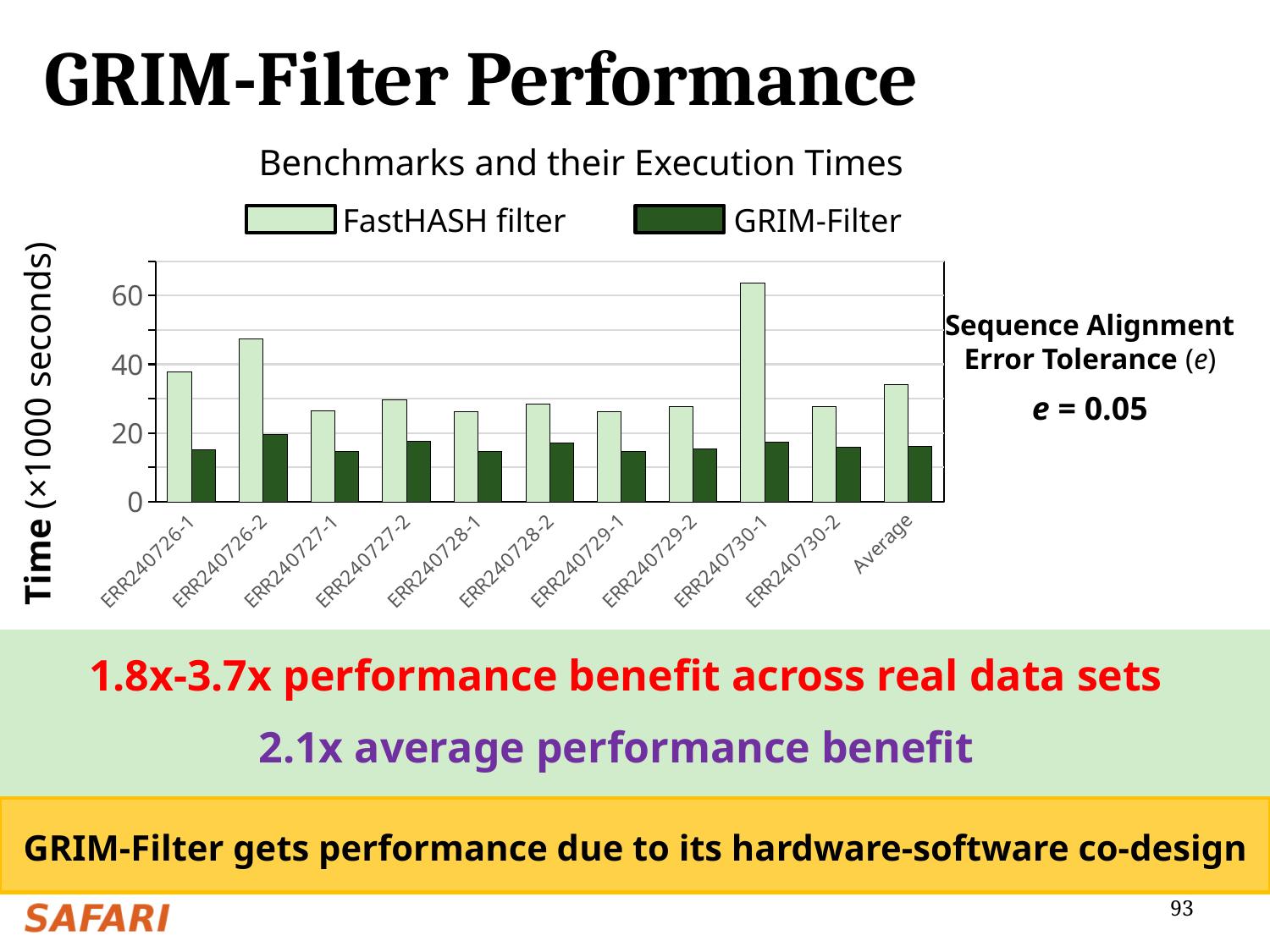
Which FastHASH filter value is larger, ERR240726-2 or ERR240727-1? ERR240726-2 For the Average category, which series has the larger value, FastHASH filter or GRIM-Filter? FastHASH filter How many series does the chart's legend list? 2 What kind of chart is shown on the slide? bar chart How many categories are shown along the x axis of the chart? 11 Which category has the highest FastHASH filter execution time? ERR240730-1 Is the FastHASH filter value for ERR240730-1 greater or less than 60? greater What is the label of the chart's y axis? Time (×1000 seconds) Is the GRIM-Filter value for ERR240726-1 greater or less than 20? less Is the FastHASH filter value for ERR240726-2 greater or less than 40? greater What is the title of the chart? Benchmarks and their Execution Times